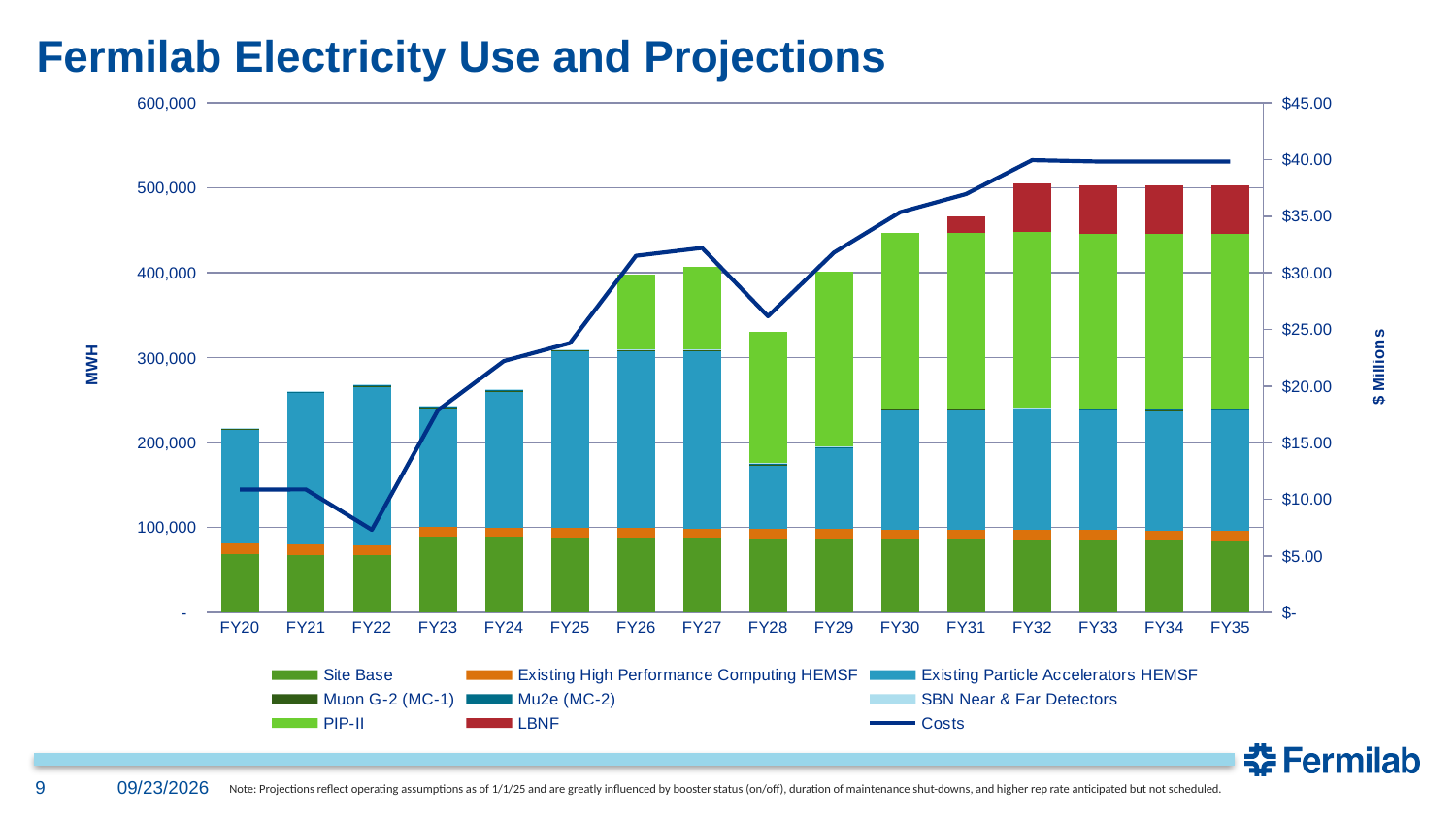
Is the total electricity use for FY22 greater or less than 300,000 MWH? less Does the Costs line rise or fall from FY22 to FY27? rise What is the title of the chart? Fermilab Electricity Use and Projections Which fiscal year has the lowest total electricity use (shortest stacked bar)? FY20 Is the total electricity use for FY30 greater or less than 400,000 MWH? greater Which has the larger total electricity use, FY28 or FY29? FY29 What kind of chart is shown on the slide? Stacked bar chart with a line What is the label of the right-hand vertical axis? $ Millions How many fiscal years are shown along the x axis? 16 How many entries does the legend list? 9 In which fiscal year is the Costs line at its lowest? FY22 Is the Costs value for FY22 greater or less than $10.00 million? less